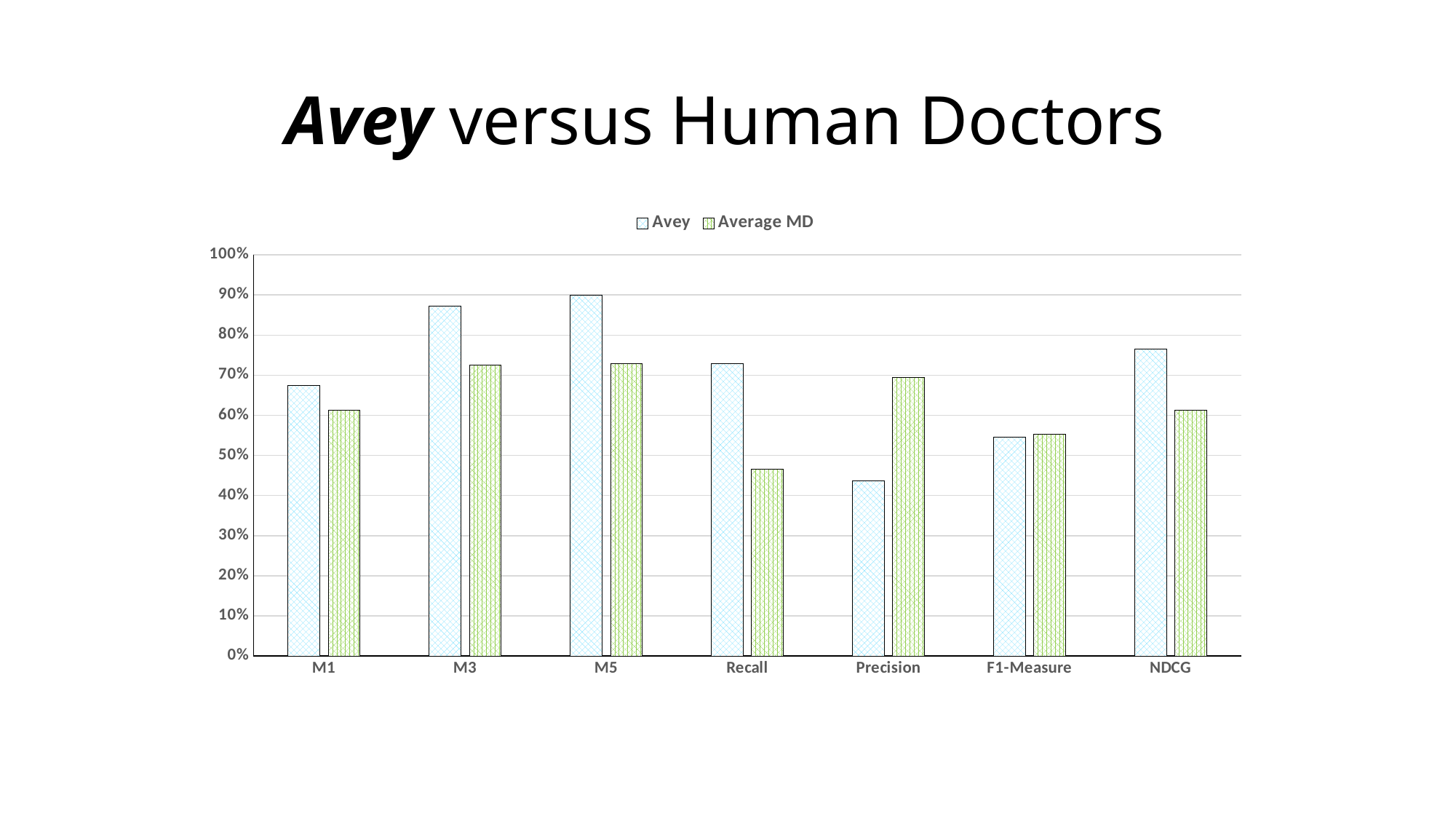
What kind of chart is shown on the slide? bar chart For Precision, which series has the larger value, Avey or Average MD? Average MD Which category has the highest value for the Avey series? M5 How many series does the legend list? 2 Is the Average MD value for Recall greater or less than 50%? less Which category has the lowest value for the Average MD series? Recall How many categories are shown on the x axis? 7 Which category has the lowest value for the Avey series? Precision Is the Avey value for M5 greater or less than 80%? greater Is the Avey value for Precision greater or less than 50%? less What are the two series named in the legend? Avey and Average MD For Recall, which series has the larger value, Avey or Average MD? Avey